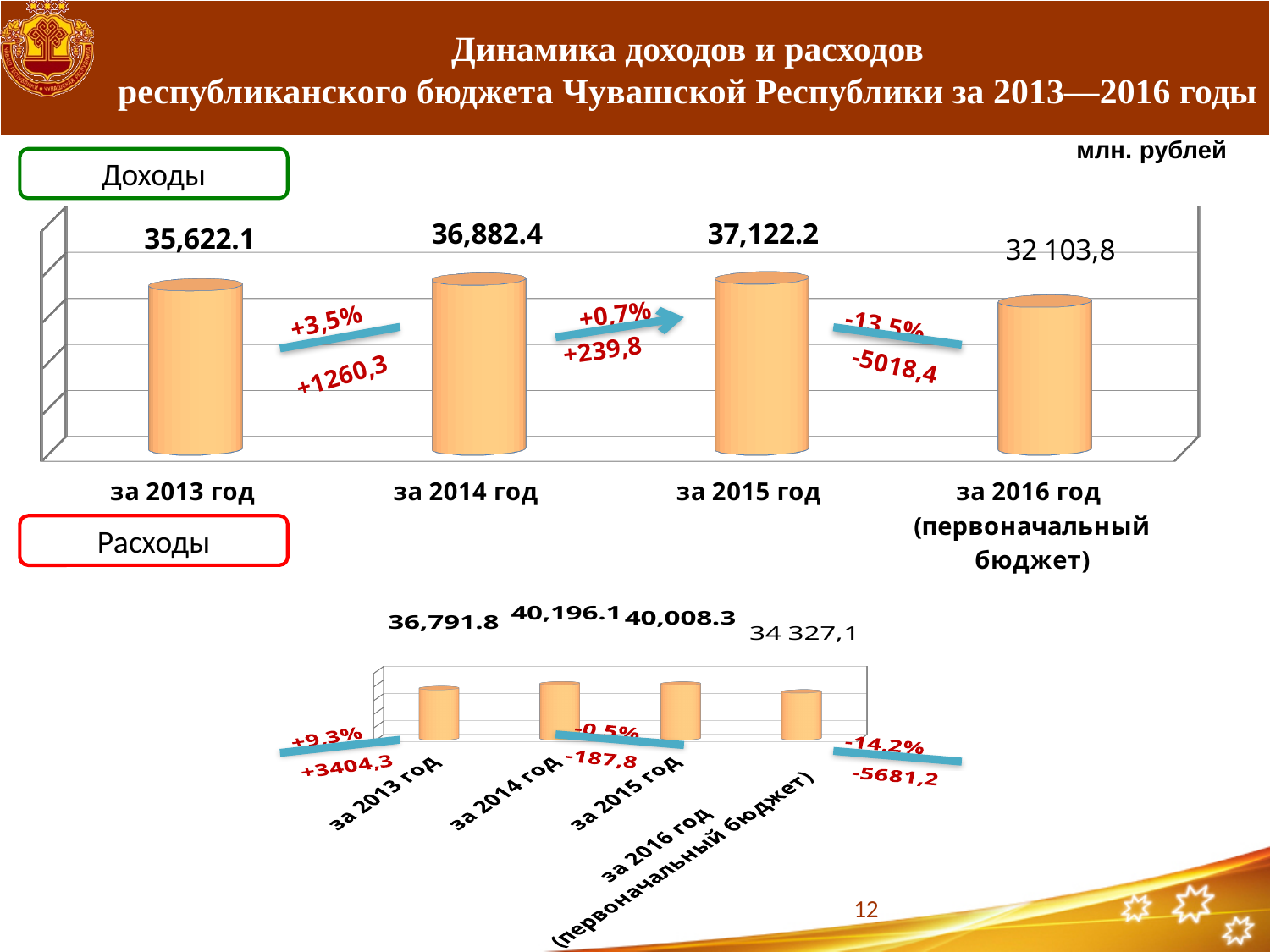
How many bars does the Доходы chart have? 4 In the Доходы chart, what is the difference between the values for за 2014 год and за 2013 год? 1260.3 In the Расходы chart, which year has the highest value? за 2014 год In the Доходы chart, which year has the highest value? за 2015 год What type of chart is the Расходы chart? bar chart In the Доходы chart, what is the value for за 2013 год? 35,622.1 In the Расходы chart, what is the difference between the values for за 2015 год and за 2016 год (первоначальный бюджет)? 5681.2 In the Расходы chart, which is larger: the value for за 2013 год or за 2015 год? за 2015 год In the Расходы chart, what is the value for за 2014 год? 40,196.1 In the Расходы chart, what is the value for за 2016 год (первоначальный бюджет)? 34 327,1 In the Доходы chart, what is the value for за 2015 год? 37,122.2 In the Доходы chart, which year has the lowest value? за 2016 год (первоначальный бюджет)